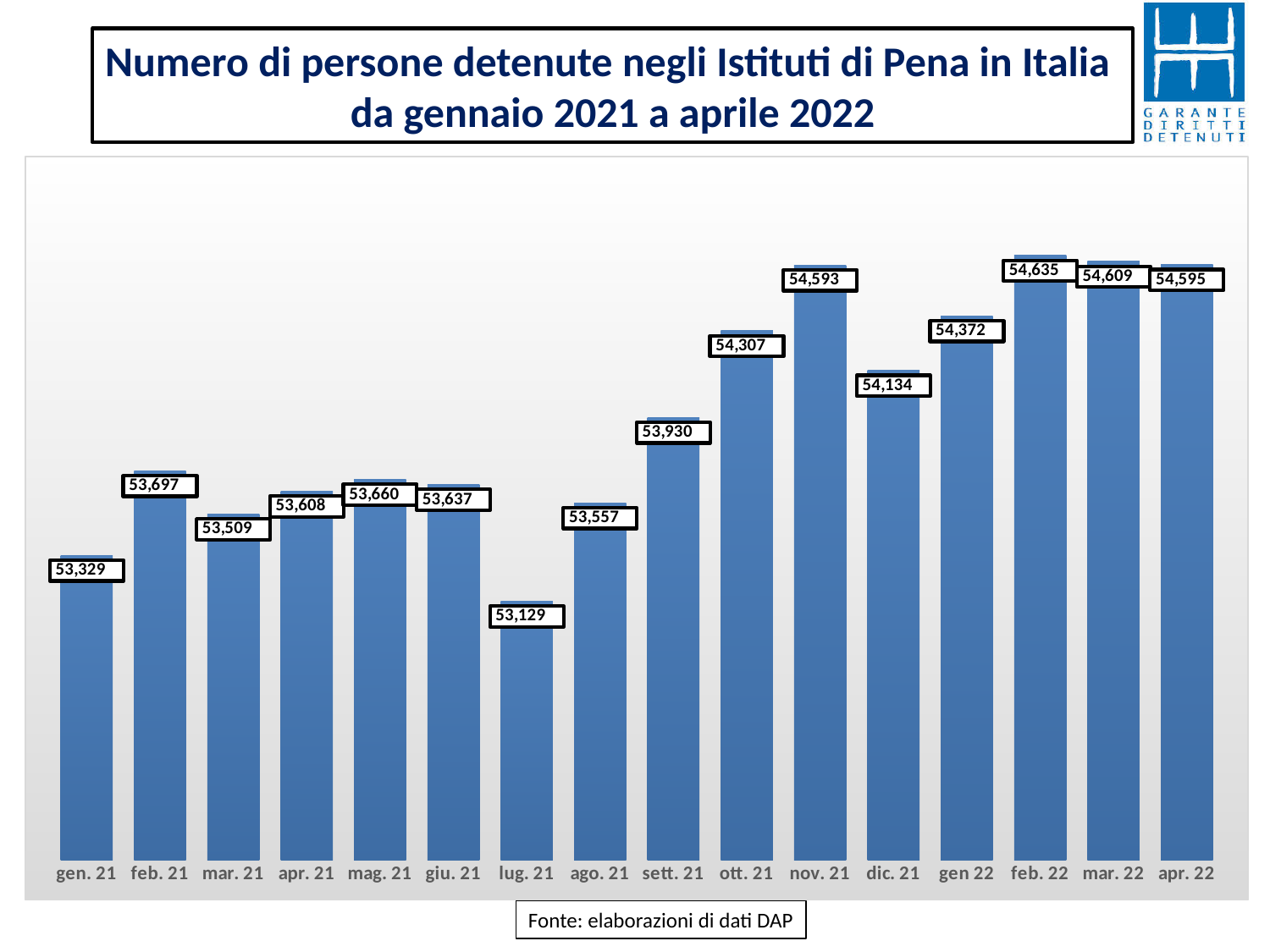
What is the difference between the values for nov. 21 and ott. 21? 286 What kind of chart is shown on the slide? bar chart What is the value for gen. 21? 53,329 What is the value for lug. 21? 53,129 Which is larger, the value for dic. 21 or the value for gen 22? gen 22 Which month has the lowest value? lug. 21 Which month has the highest value? feb. 22 What is the title of the chart? Numero di persone detenute negli Istituti di Pena in Italia da gennaio 2021 a aprile 2022 What is the value for nov. 21? 54,593 What is the difference between the values for feb. 22 and lug. 21? 1,506 What is the value for sett. 21? 53,930 How many months are shown on the chart? 16